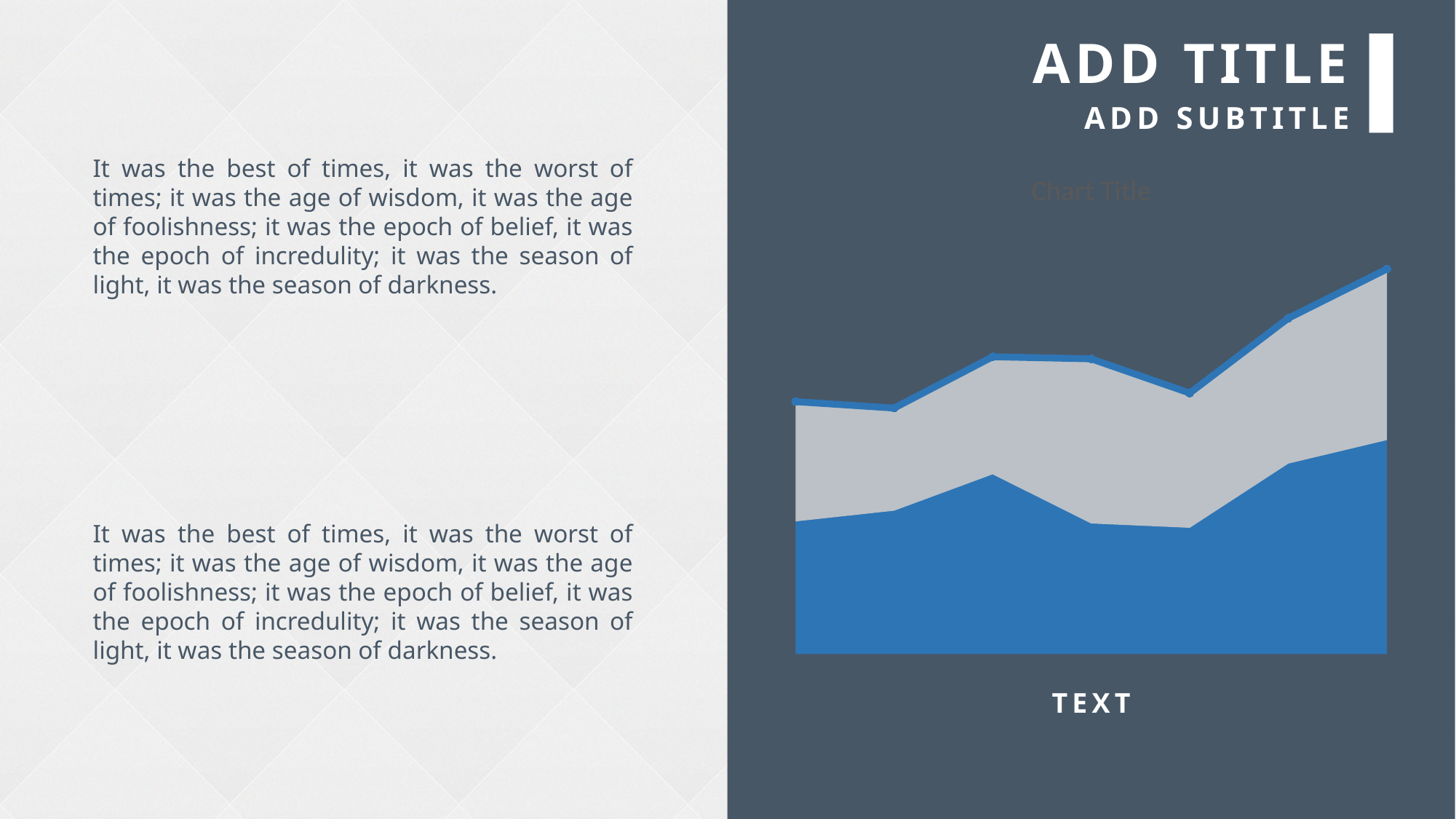
Does the blue (bottom) series end higher or lower at the rightmost point than at the leftmost point? Higher How many data points does each series in the chart have along the x axis? 7 What colour is the top series in the area chart? Grey What kind of chart is shown on the slide? Area chart How many series are plotted in the stacked area chart? 3 At which point along the x axis does the top of the stacked area reach its highest value, the first or the last? The last Between the first and last points, does the blue series rise or fall overall? Rise Does the top boundary of the stacked area end higher or lower at the right than it starts at the left? Higher What colour is the bottom series in the area chart? Blue